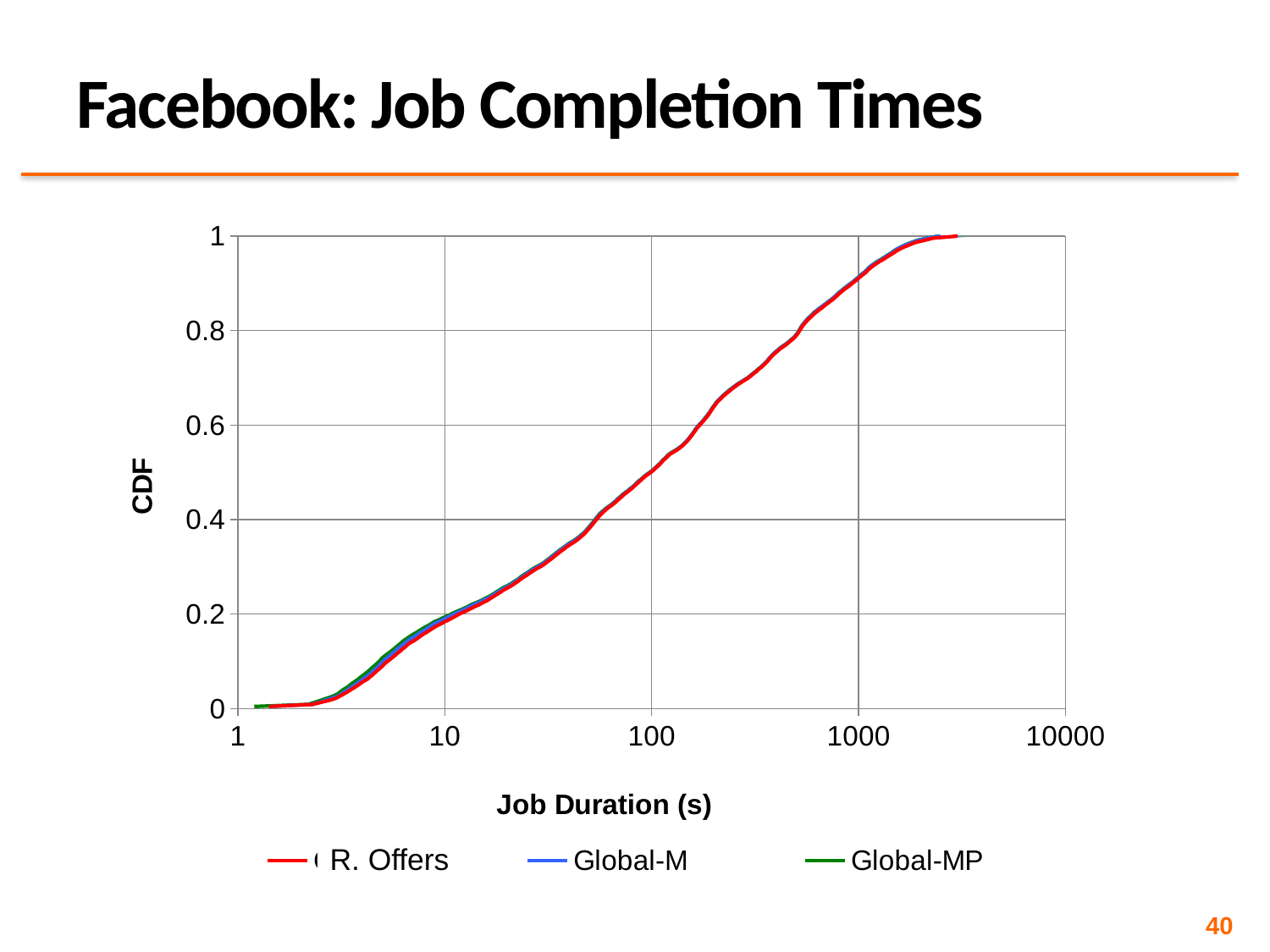
How many series does the legend list? 3 Is the CDF value for R. Offers at a job duration of 1000 s greater or less than 1? less What kind of chart is shown on the slide? line chart Do the CDF values rise or fall as job duration increases along the x axis? rise Is the CDF value for R. Offers at a job duration of 1000 s greater or less than 0.8? greater Is the CDF value for Global-MP at a job duration of 100 s greater or less than 0.8? less What is the label of the x axis? Job Duration (s) What is the title of the chart on the slide? Facebook: Job Completion Times